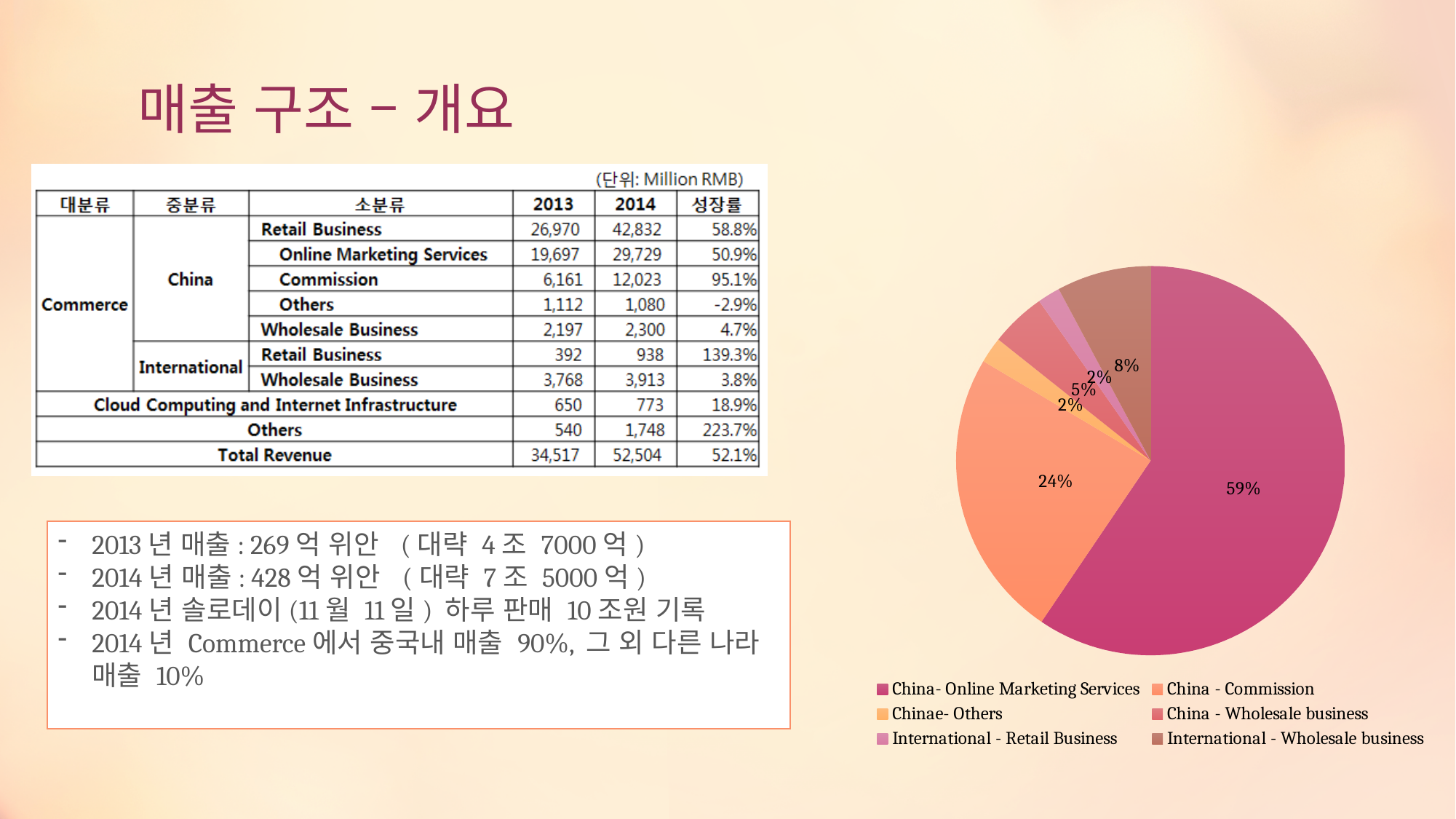
In the pie chart, what is the difference in percentage points between China - Online Marketing Services and China - Commission? 35 In the pie chart, what share does International - Wholesale business have? 8% In the pie chart, what share does China - Wholesale business have? 5% How many slices does the pie chart have? 6 In the pie chart, what is the difference in percentage points between International - Wholesale business and China - Wholesale business? 3 Which category has the largest slice in the pie chart? China - Online Marketing Services In the pie chart, what share does International - Retail Business have? 2% What kind of chart is shown on the right side of the slide? pie chart In the pie chart, which is larger: China - Commission or International - Wholesale business? China - Commission How many entries does the pie chart's legend list? 6